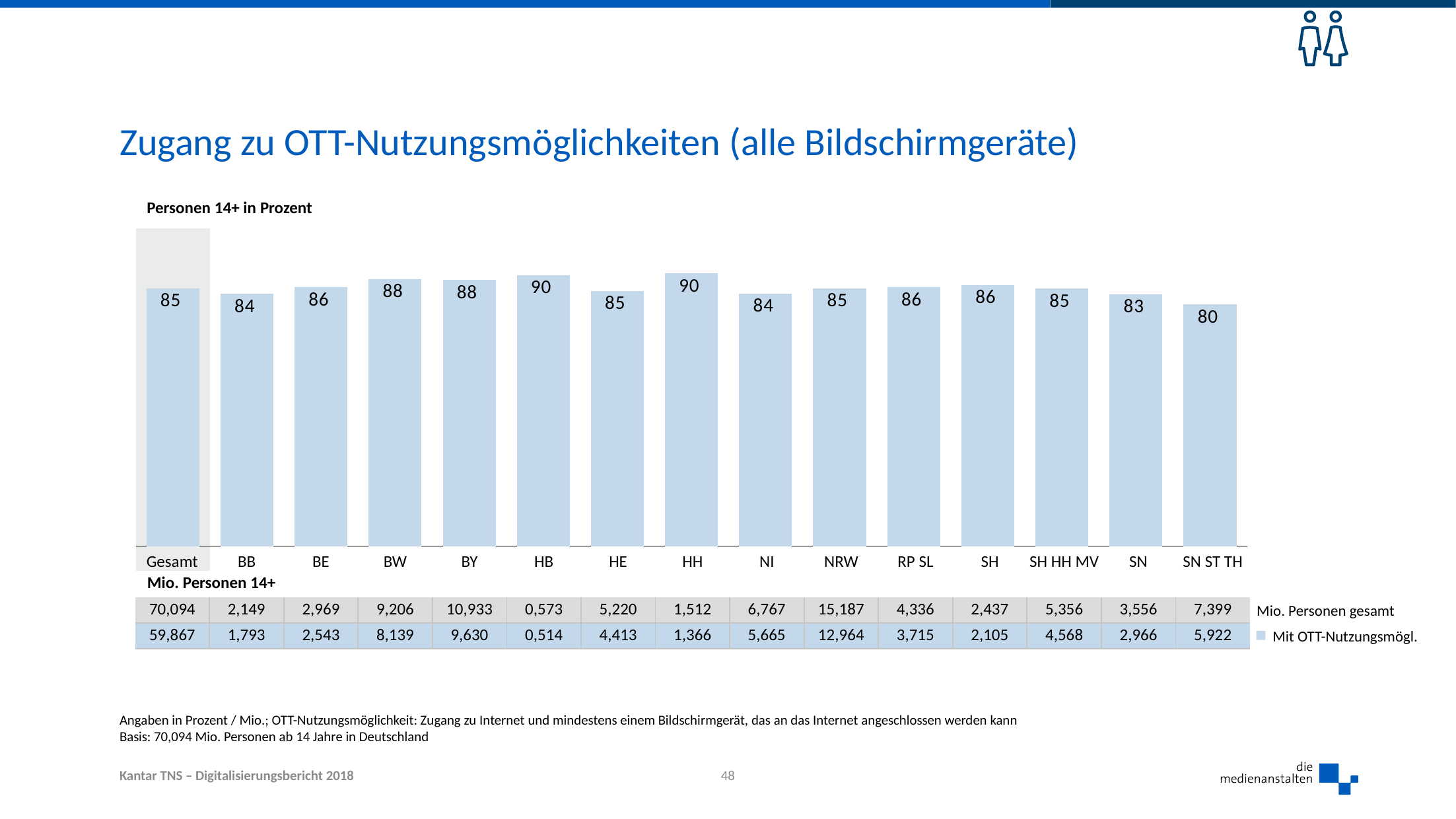
According to the table below the chart, how many Mio. Personen gesamt are listed for NRW? 15,187 According to the table below the chart, how many Mio. Personen with OTT-Nutzungsmögl. are listed for BY? 9,630 What is the value for BY in the bar chart? 88 What is the value for HB in the bar chart? 90 Which is larger, the value for BW or the value for SN? BW Which category has the lowest value in the bar chart? SN ST TH How many categories are shown on the x axis of the bar chart? 15 What is the value for SN ST TH in the bar chart? 80 What is the difference between the values for HH and SN ST TH? 10 What is the value for Gesamt in the bar chart? 85 What is the title of the slide containing the chart? Zugang zu OTT-Nutzungsmöglichkeiten (alle Bildschirmgeräte) What kind of chart is shown on the slide? bar chart